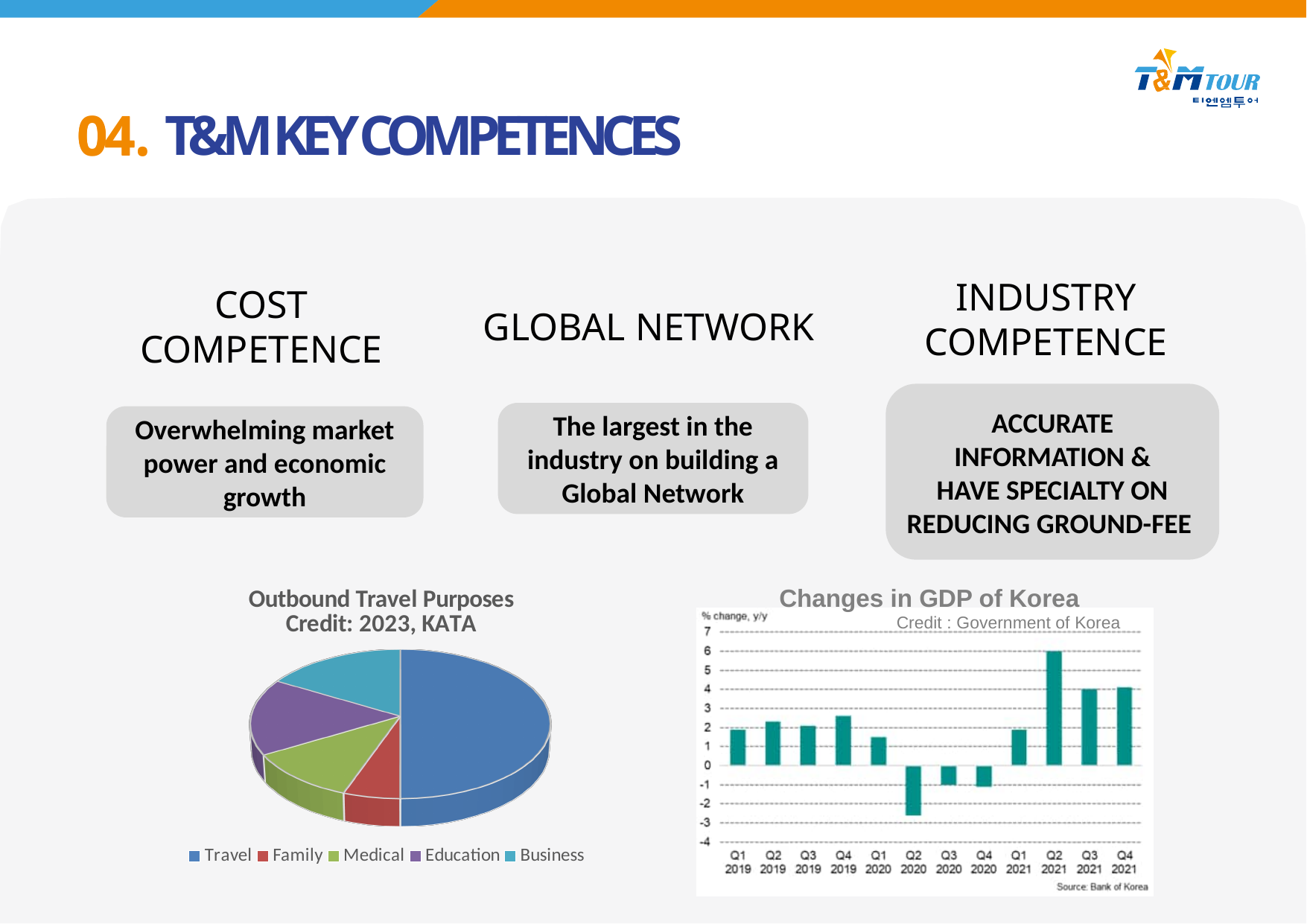
In the 'Changes in GDP of Korea' chart, which quarter has the highest value? Q2 2021 How many categories does the legend of the 'Outbound Travel Purposes' chart list? 5 What kind of chart is the 'Changes in GDP of Korea' chart? bar chart In the 'Outbound Travel Purposes' chart, which slice is larger, Family or Education? Education In the 'Changes in GDP of Korea' chart, which is larger, the value for Q2 2021 or Q3 2021? Q2 2021 In the 'Changes in GDP of Korea' chart, how many quarters are shown on the x axis? 12 In the 'Outbound Travel Purposes' chart, which travel purpose has the largest slice? Travel What kind of chart is the 'Outbound Travel Purposes' chart? pie chart In the 'Changes in GDP of Korea' chart, is the value for Q2 2020 greater or less than -2? less In the 'Changes in GDP of Korea' chart, which quarter has the lowest value? Q2 2020 In the 'Changes in GDP of Korea' chart, is the value for Q2 2021 greater or less than 5? greater In the 'Outbound Travel Purposes' chart, which travel purpose has the smallest slice? Family